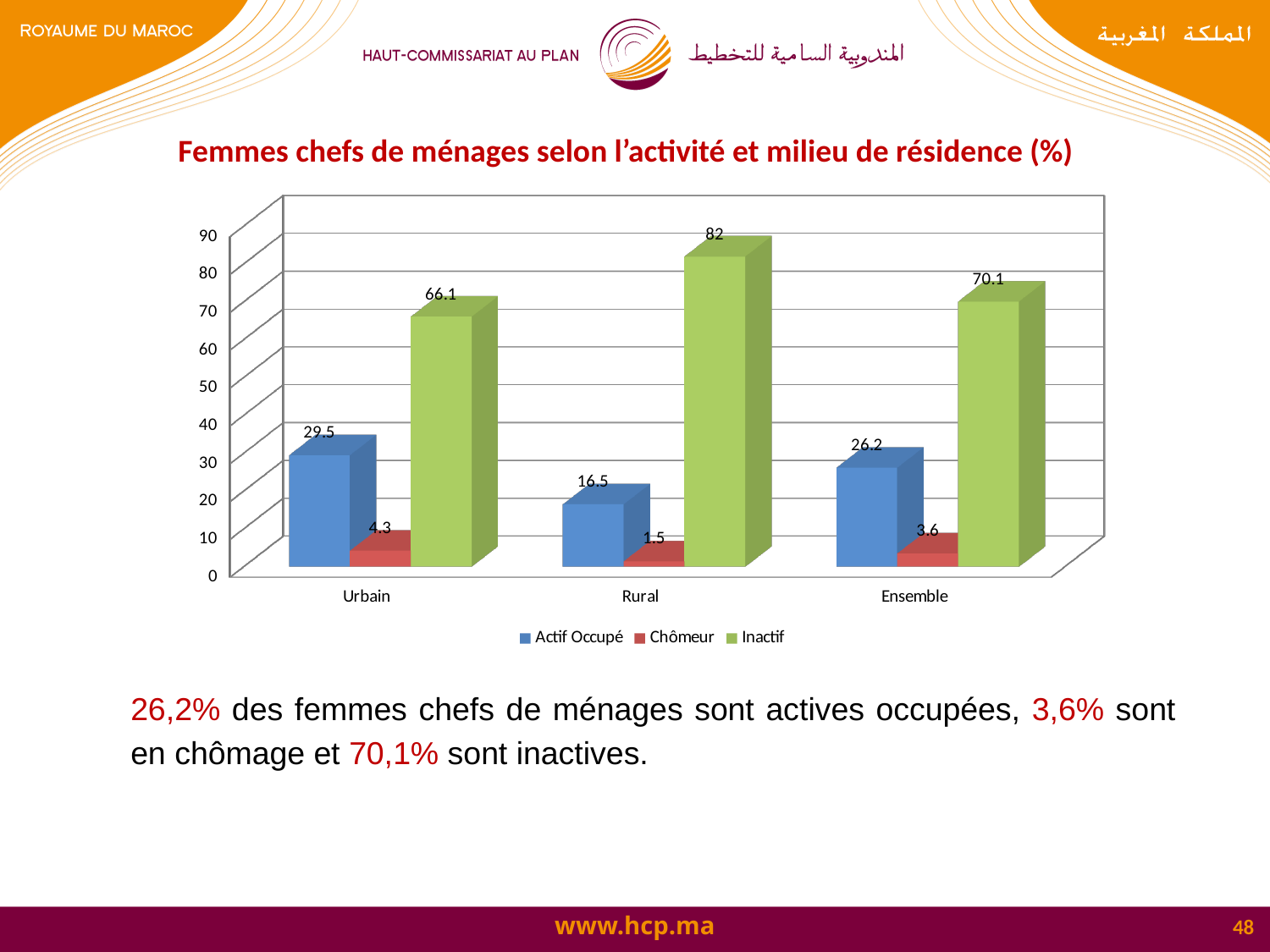
How many series does the legend list? 3 Which milieu has the lowest Chômeur value? Rural What is the value for Inactif in Rural? 82 How many categories are shown on the x axis? 3 Which milieu has the highest Inactif value? Rural Is the value for Inactif in Ensemble greater or less than 60? greater What kind of chart is shown on the slide? bar chart Which is larger, Actif Occupé in Urbain or Actif Occupé in Rural? Urbain What is the title of the chart? Femmes chefs de ménages selon l'activité et milieu de résidence (%) What is the value for Actif Occupé in Urbain? 29.5 What is the difference between the Inactif values for Rural and Urbain? 15.9 What is the value for Chômeur in Ensemble? 3.6